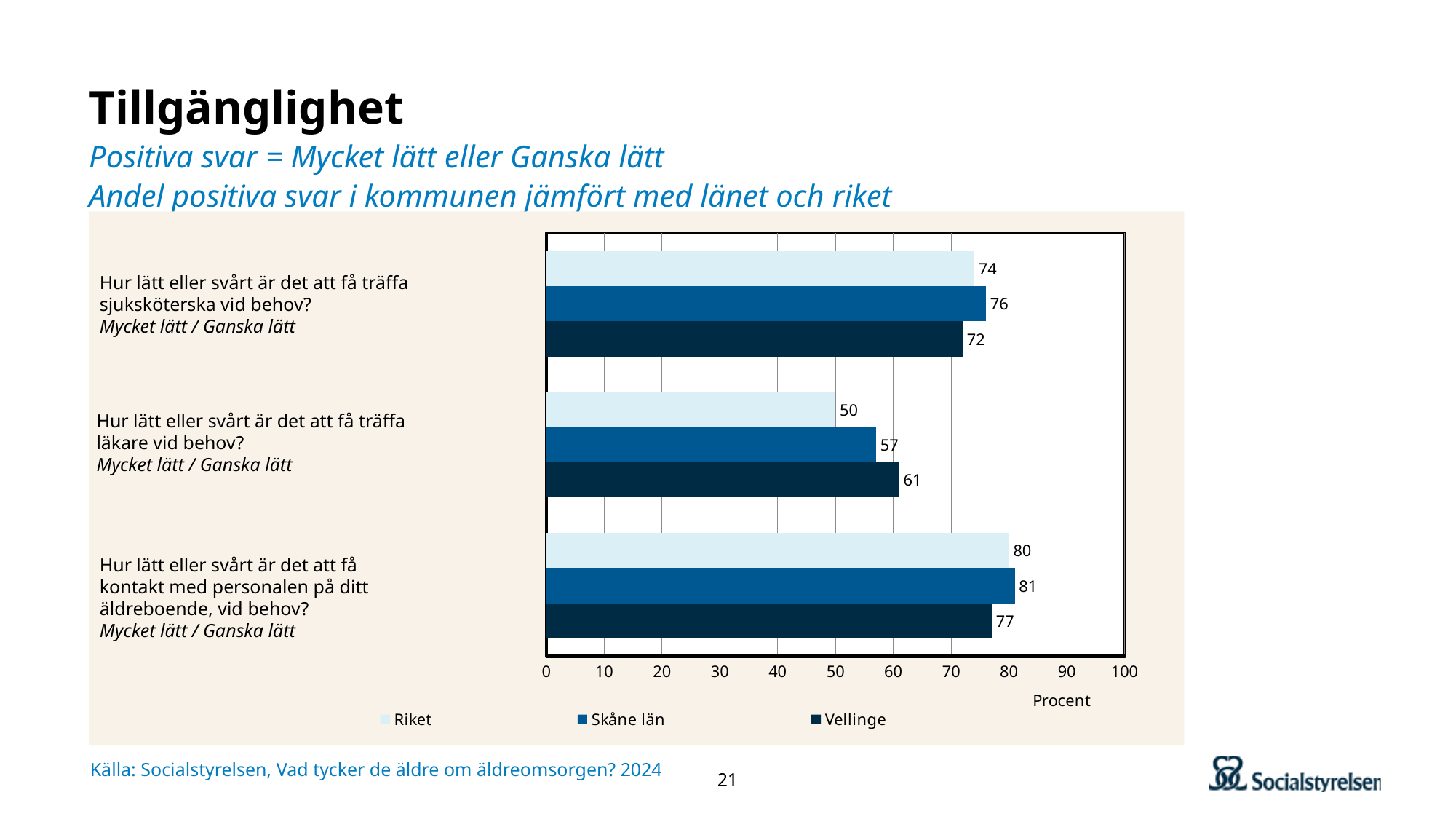
Which series has the lowest value on the question about meeting a nurse (sjuksköterska) when needed? Vellinge Is the value for Riket on the question about meeting a doctor (läkare) greater or less than 60? less What kind of chart is shown on the slide? bar chart Which is larger on the question about contact with staff at the elderly home: Skåne län or Vellinge? Skåne län What is the value for Vellinge on the question about how easy it is to meet a doctor (läkare) when needed? 61 What is the difference between Vellinge and Riket on the question about meeting a doctor (läkare) when needed? 11 What is the value for Skåne län on the question about how easy it is to meet a nurse (sjuksköterska) when needed? 76 How many questions (categories) are shown in the chart? 3 What unit label is shown under the x axis of the chart? Procent Which series has the highest value on the question about meeting a doctor (läkare) when needed? Vellinge How many series does the legend list? 3 What is the value for Riket on the question about getting in contact with staff at the elderly home (äldreboende)? 80